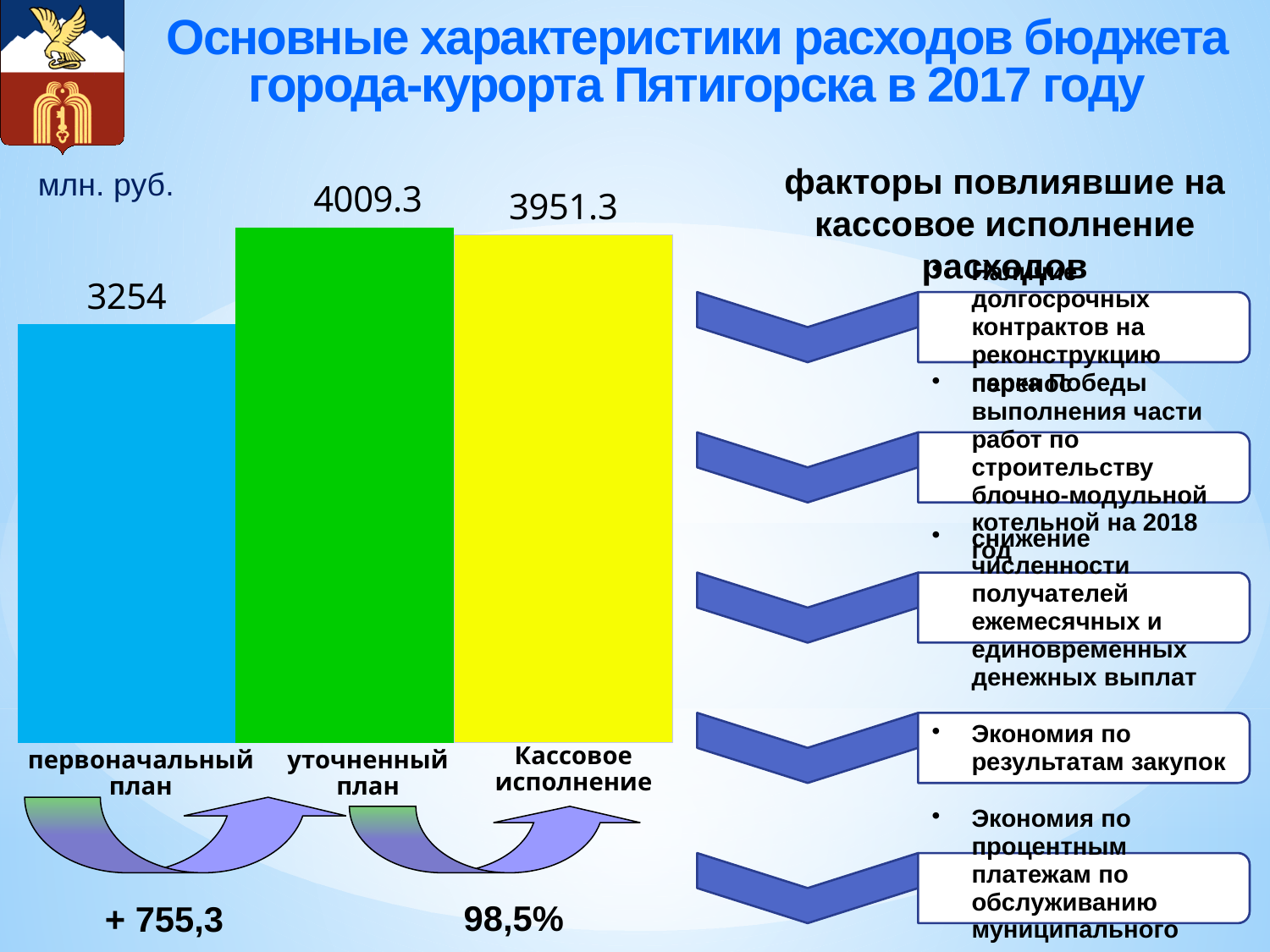
Which category has the lowest value? первоначальный план How many bars are shown in the chart? 3 What is the value for Кассовое исполнение? 3951.3 What is the value for первоначальный план? 3254 What unit is indicated for the chart values? млн. руб. What is the difference between уточненный план and первоначальный план? 755.3 Which is larger, Кассовое исполнение or первоначальный план? Кассовое исполнение Which category has the highest value? уточненный план What colour is the bar for Кассовое исполнение? yellow What is the difference between уточненный план and Кассовое исполнение? 58 What kind of chart is shown on the slide? bar chart What is the value for уточненный план? 4009.3